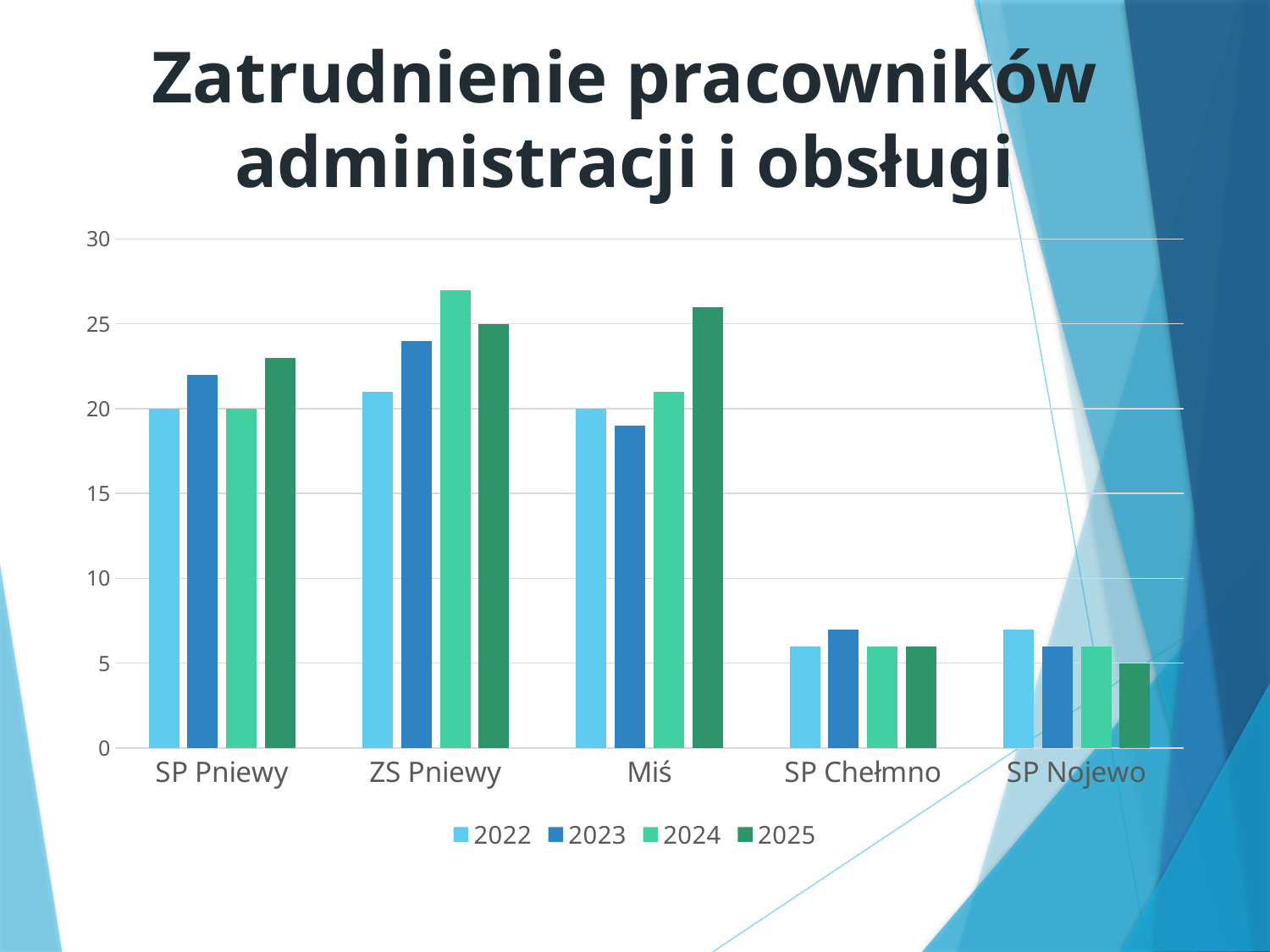
What kind of chart is shown on the slide? bar chart How many categories are shown on the x axis? 5 Which is larger for Miś: the 2025 value or the 2022 value? 2025 Is the value for SP Chełmno in 2023 greater or less than 10? less Is the value for ZS Pniewy in 2024 greater or less than 25? greater Is the value for Miś in 2023 greater or less than 20? less What is the value for SP Nojewo in 2025? 5 What is the value for SP Pniewy in 2022? 20 What is the title of the chart? Zatrudnienie pracowników administracji i obsługi Which category has the highest value in 2024? ZS Pniewy How many series does the legend list? 4 What is the value for ZS Pniewy in 2025? 25